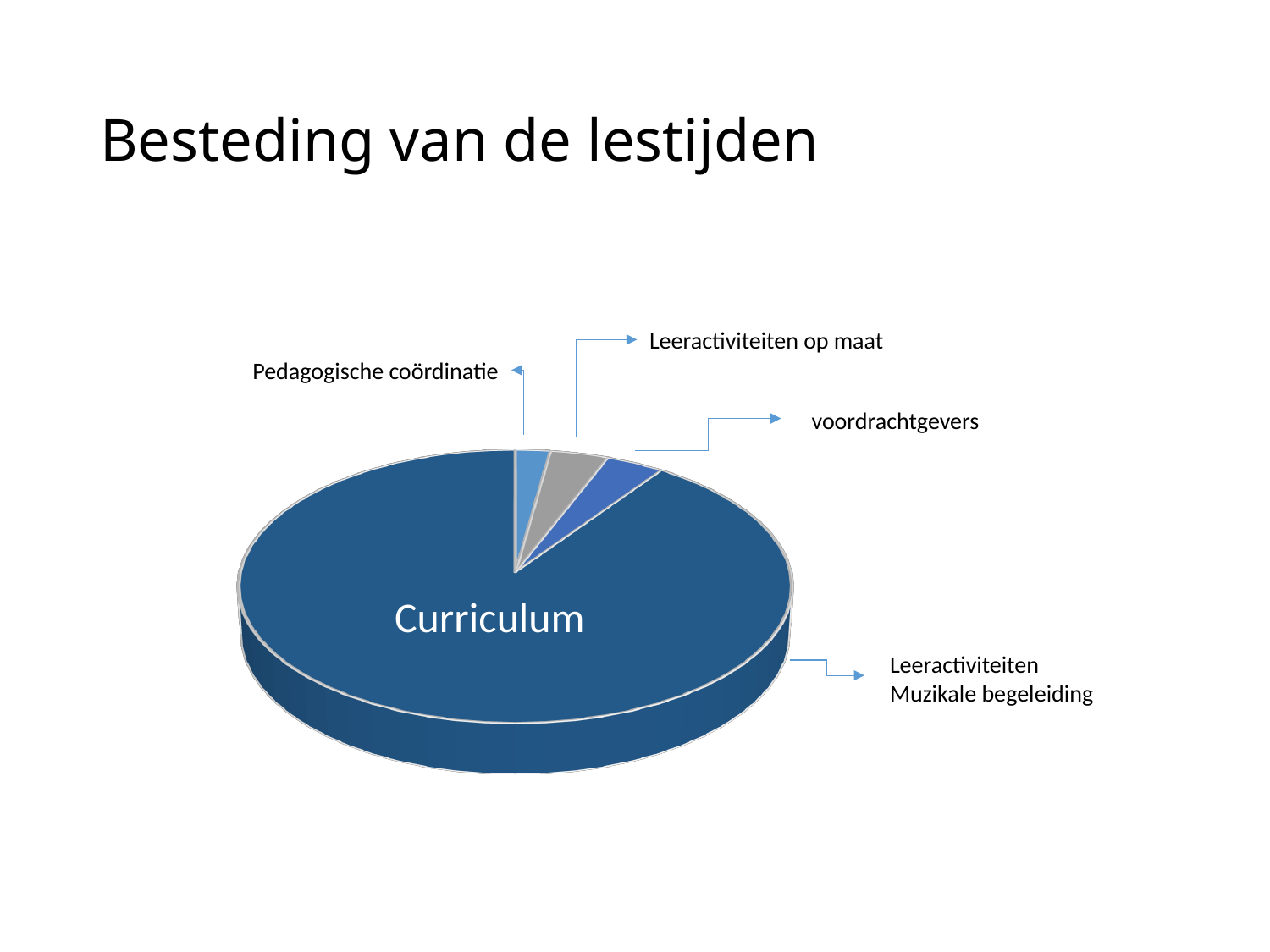
How many slices does the pie chart have? 4 Which slice is larger: Curriculum or voordrachtgevers? Curriculum What is the title of the slide containing the pie chart? Besteding van de lestijden Which slice of the pie chart is the largest? Curriculum What colour is the Curriculum slice of the pie chart? dark blue What kind of chart is shown on the slide? pie chart Which slice of the pie chart is the smallest? Pedagogische coördinatie Which slice is larger: voordrachtgevers or Pedagogische coördinatie? voordrachtgevers